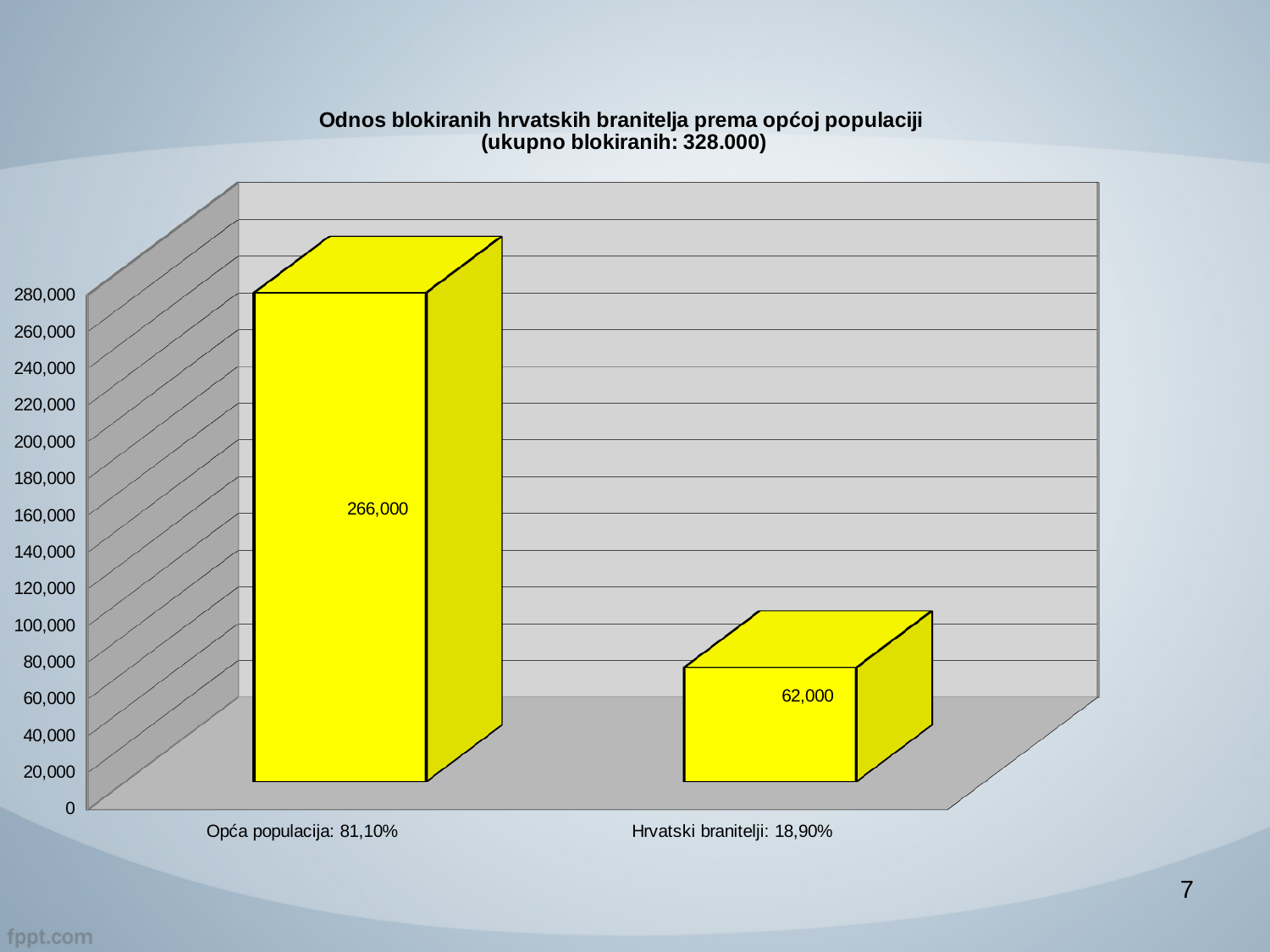
What colour are the bars in the chart? yellow What kind of chart is shown on the slide? bar chart What is the title of the chart? Odnos blokiranih hrvatskih branitelja prema općoj populaciji (ukupno blokiranih: 328.000) Which category has the lowest value? Hrvatski branitelji: 18,90% Is the value for "Hrvatski branitelji: 18,90%" greater or less than 100,000? less Which category has the highest value? Opća populacija: 81,10% What is the value for "Hrvatski branitelji: 18,90%"? 62,000 Which is larger, the value for "Opća populacija: 81,10%" or for "Hrvatski branitelji: 18,90%"? Opća populacija: 81,10% What is the difference between the values for "Opća populacija: 81,10%" and "Hrvatski branitelji: 18,90%"? 204,000 What is the value for "Opća populacija: 81,10%"? 266,000 How many categories are shown in the chart? 2 Is the value for "Opća populacija: 81,10%" greater or less than 200,000? greater